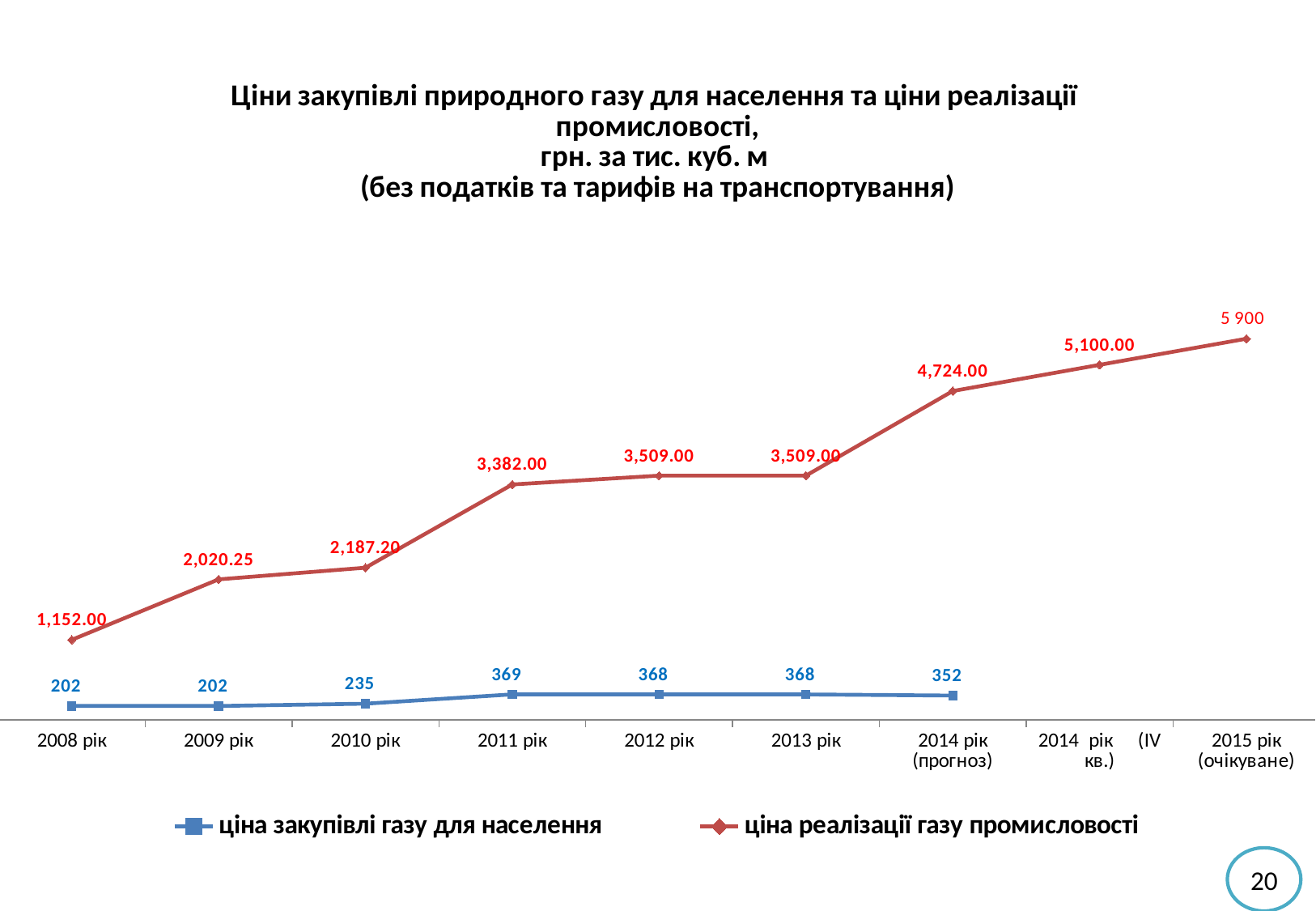
What is the value of the 'ціна реалізації газу промисловості' series for 2009 рік? 2,020.25 How many series does the legend list? 2 Which is larger for the 'ціна реалізації газу промисловості' series: the value for 2009 рік or for 2010 рік? 2010 рік In which category does the 'ціна реалізації газу промисловості' series reach its highest value? 2015 рік (очікуване) How many categories are shown on the x axis of the chart? 9 What is the difference between the 'ціна реалізації газу промисловості' values for 2014 рік (IV кв.) and 2014 рік (прогноз)? 376.00 What is the value of the 'ціна реалізації газу промисловості' series for 2011 рік? 3,382.00 What is the value of the 'ціна закупівлі газу для населення' series for 2014 рік (прогноз)? 352 Does the 'ціна реалізації газу промисловості' series generally rise or fall from 2008 рік to 2015 рік (очікуване)? rises What kind of chart is shown on the slide? line chart In which category is the 'ціна реалізації газу промисловості' series lowest? 2008 рік What is the difference between the 'ціна закупівлі газу для населення' values for 2011 рік and 2010 рік? 134